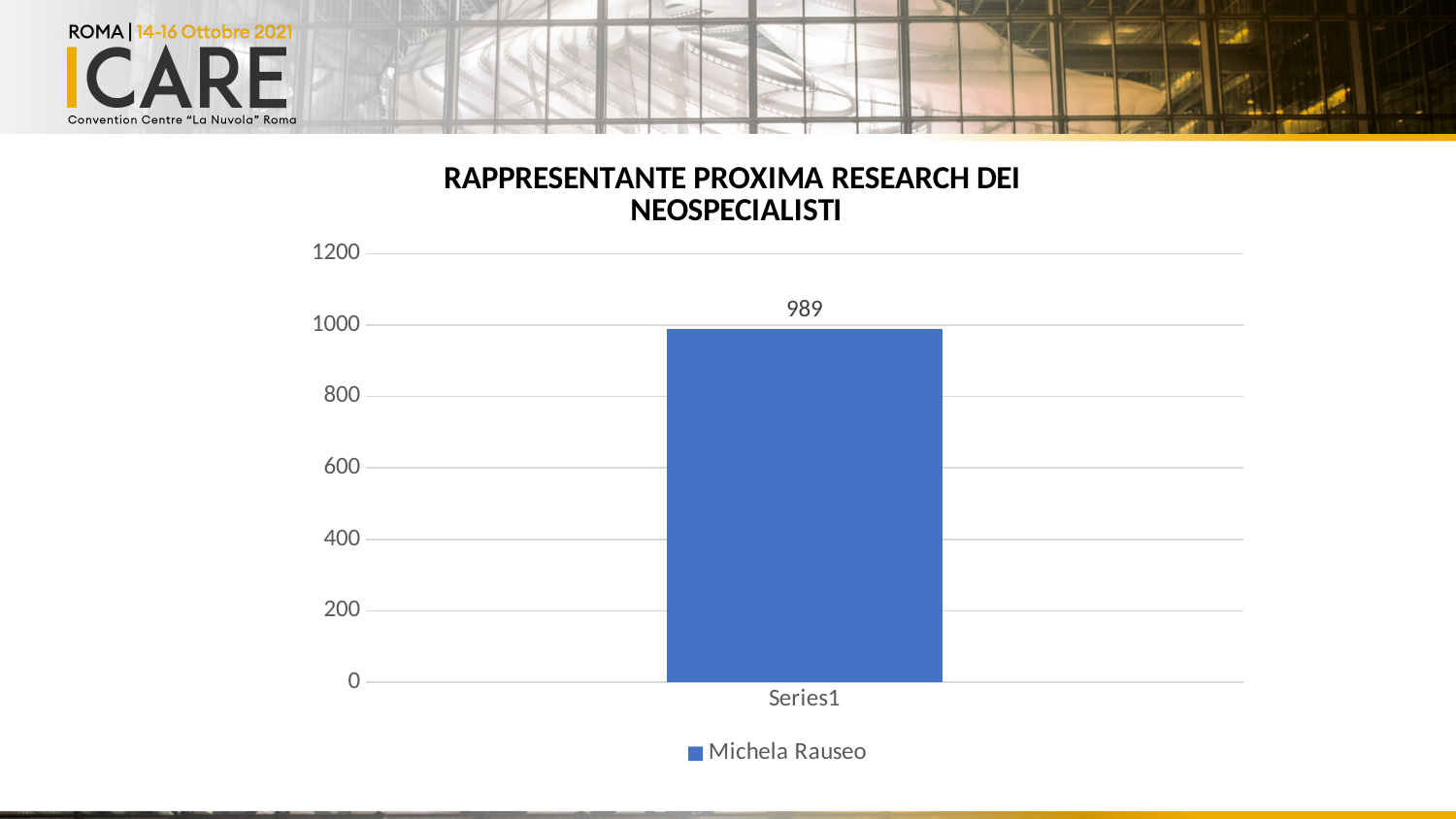
What is the value of the bar for Michela Rauseo? 989 What type of chart is shown on the slide? bar chart What is the category label shown on the x axis? Series1 How many bars are plotted in the chart? 1 What is the maximum value shown on the y axis? 1200 How many series does the legend list? 1 What is the title of the chart? RAPPRESENTANTE PROXIMA RESEARCH DEI NEOSPECIALISTI Is the value for Michela Rauseo greater or less than 800? greater What series name is shown in the legend? Michela Rauseo Is the value for Michela Rauseo greater or less than 1000? less